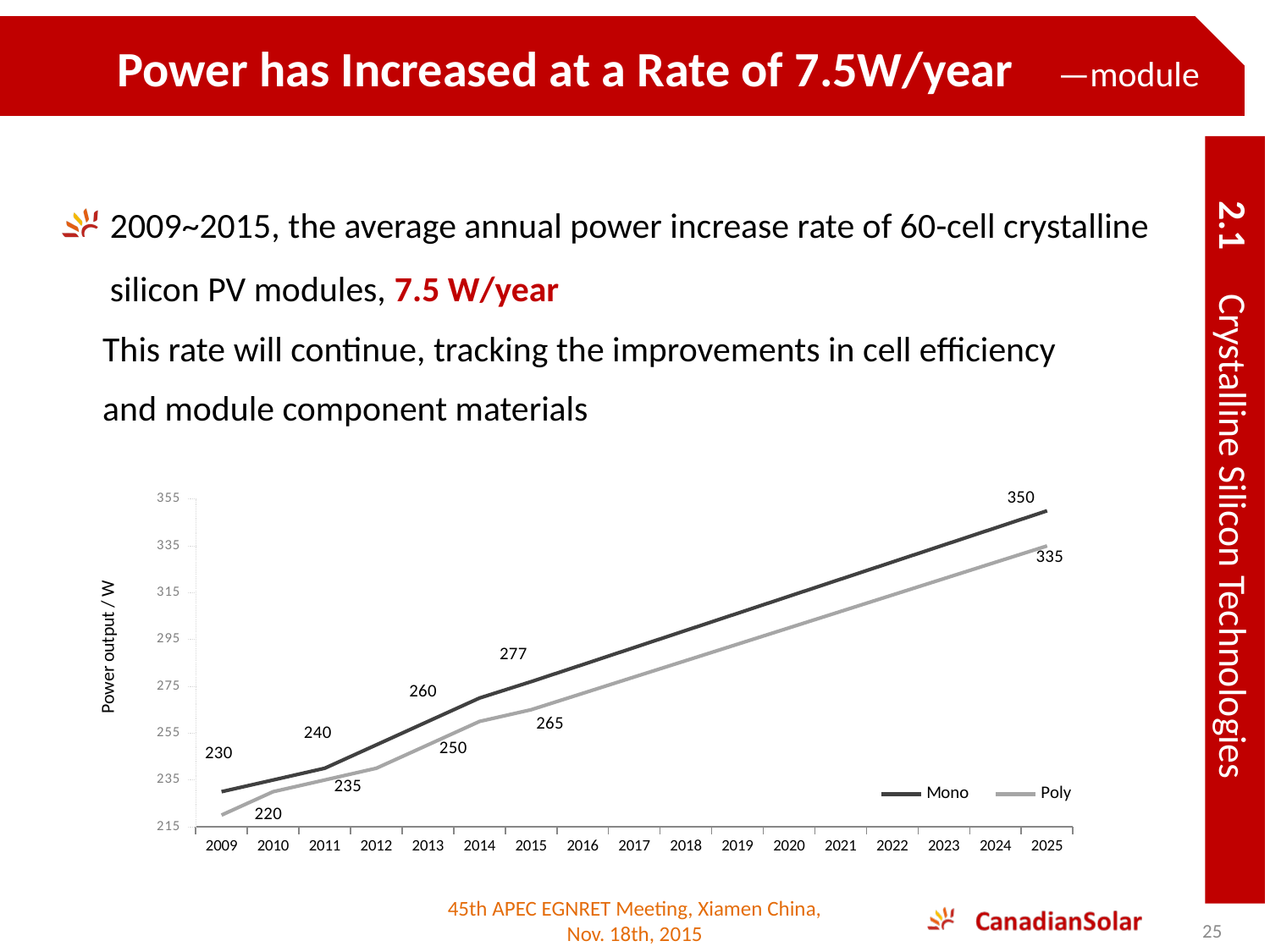
What is the Poly value labelled for 2013? 250 How many years are shown on the x axis? 17 Do the Poly values rise or fall from 2009 to 2025? rise What is the Mono power output value labelled for 2025? 350 By how much does the labelled Mono value increase from 2009 to 2015? 47 How many series does the legend list? 2 Is the Mono value for 2020 greater or less than 295? greater What is the difference between the Mono and Poly labelled values in 2025? 15 What is the Poly power output value labelled for 2009? 220 What is the Mono value labelled for 2015? 277 What kind of chart is shown on the slide? line chart Which series has the higher value in 2011, Mono or Poly? Mono